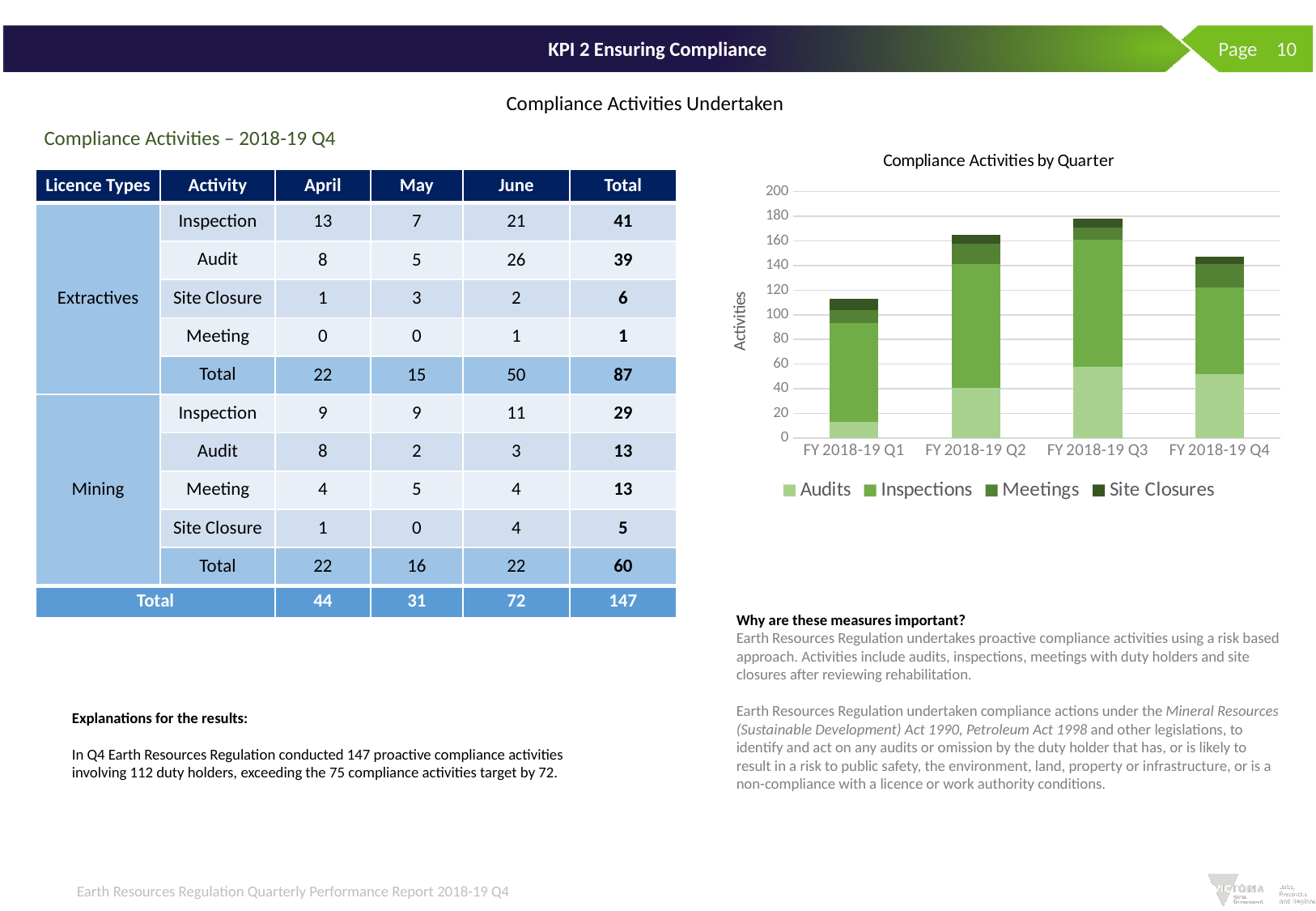
What kind of chart is 'Compliance Activities by Quarter'? Stacked bar chart In the 'Compliance Activities by Quarter' chart, is the total bar for FY 2018-19 Q3 greater or less than 160? greater In the 'Compliance Activities by Quarter' chart, is the total bar for FY 2018-19 Q4 greater or less than 160? less How many series does the legend of the 'Compliance Activities by Quarter' chart list? 4 In the 'Compliance Activities by Quarter' chart, which quarter has the shortest stacked bar? FY 2018-19 Q1 In the 'Compliance Activities by Quarter' chart, which quarter has the tallest stacked bar? FY 2018-19 Q3 How many quarters are shown on the x axis of the 'Compliance Activities by Quarter' chart? 4 In the 'Compliance Activities by Quarter' chart, which has the taller total bar, FY 2018-19 Q2 or FY 2018-19 Q4? FY 2018-19 Q2 What is the y-axis title of the 'Compliance Activities by Quarter' chart? Activities In the 'Compliance Activities by Quarter' chart, is the total bar for FY 2018-19 Q1 greater or less than 100? greater In the 'Compliance Activities by Quarter' chart, do the total bars rise or fall from FY 2018-19 Q1 to FY 2018-19 Q3? rise